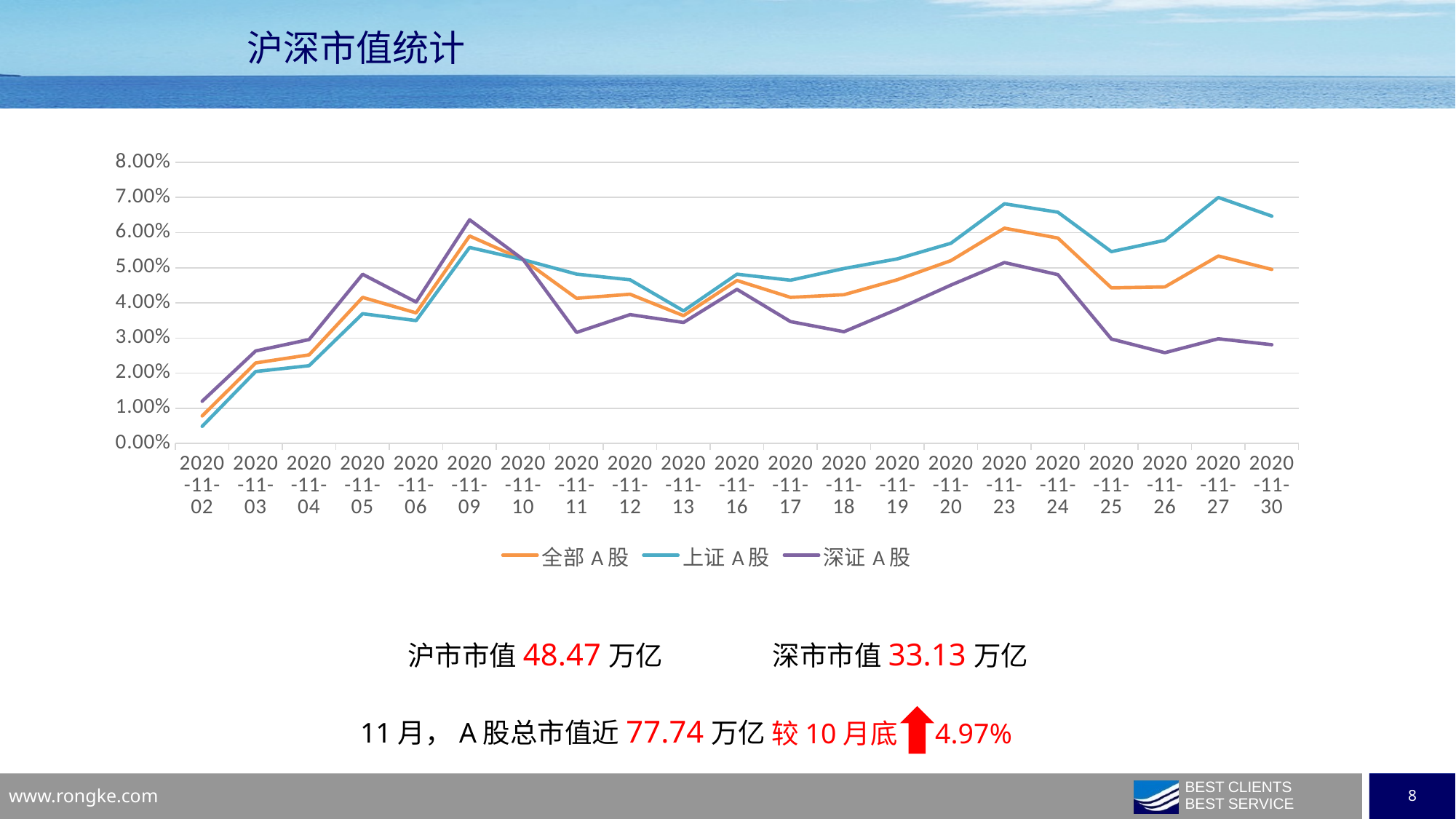
On which date does 上证 A 股 reach its highest value? 2020-11-27 What kind of chart is shown on the slide? line chart On 2020-11-09, which is larger: 深证 A 股 or 上证 A 股? 深证 A 股 Is the value for 深证 A 股 on 2020-11-26 greater or less than 3.00%? less Does the 深证 A 股 line rise or fall from 2020-11-24 to 2020-11-26? fall How many dates are plotted along the x axis? 21 On which date does 深证 A 股 reach its highest value? 2020-11-09 On which date is the value for 全部 A 股 lowest? 2020-11-02 On 2020-11-30, which is larger: 上证 A 股 or 深证 A 股? 上证 A 股 How many series does the legend list? 3 Is the value for 上证 A 股 on 2020-11-27 greater or less than 6.00%? greater Is the value for 全部 A 股 on 2020-11-23 greater or less than 5.00%? greater